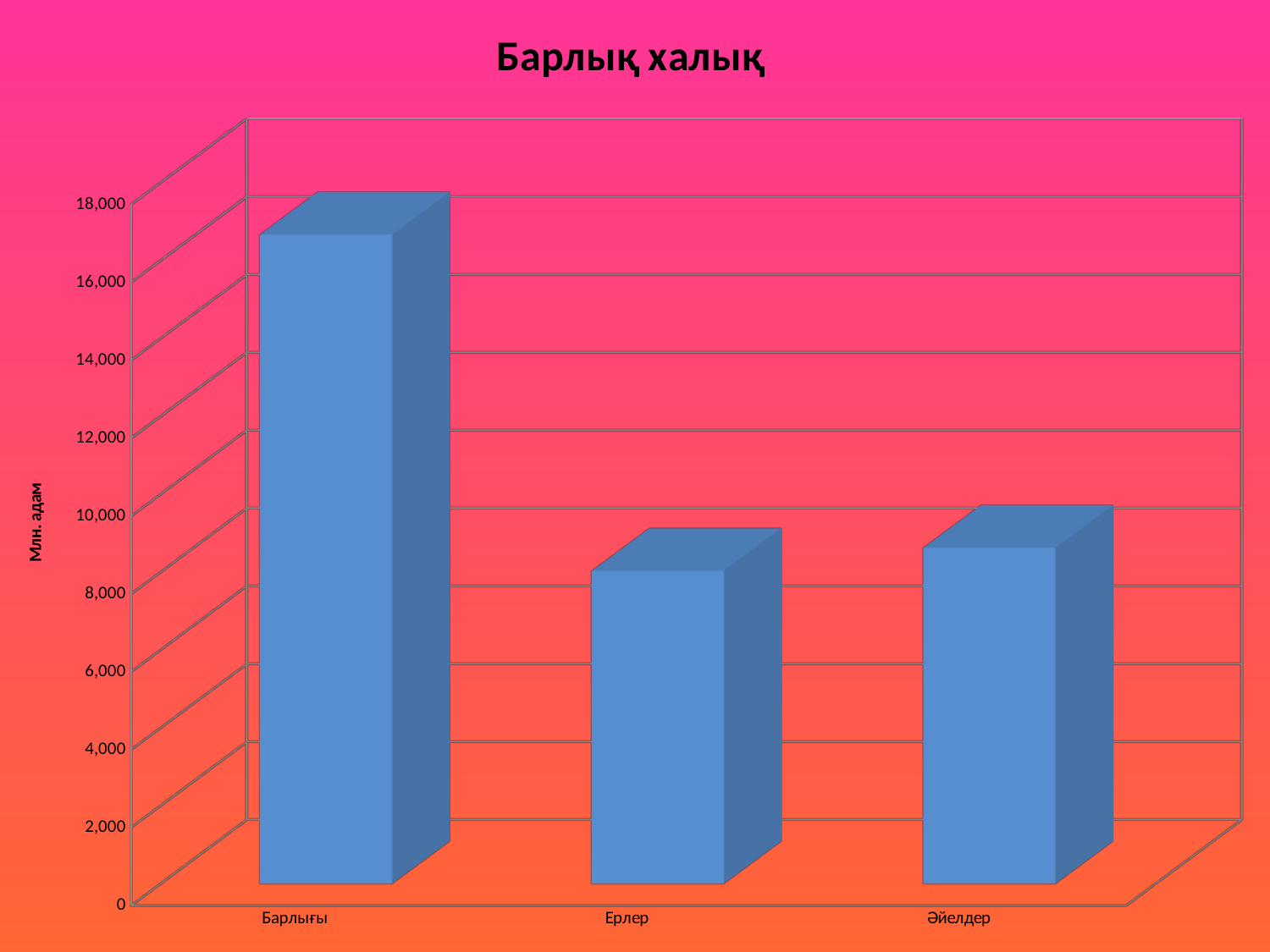
What is the label on the vertical axis of the chart? Млн. адам Is the value for Әйелдер greater or less than 10,000? less Is the value for Барлығы greater or less than 16,000? greater Which category has the lowest value in the chart? Ерлер Is the value for Ерлер greater or less than 10,000? less Which category has the highest value in the chart? Барлығы How many categories are shown on the x axis of the chart? 3 Which is larger, the value for Барлығы or the value for Ерлер? Барлығы What kind of chart is shown on the slide? bar chart Which is larger, the value for Барлығы or the value for Әйелдер? Барлығы What is the title of the chart? Барлық халық